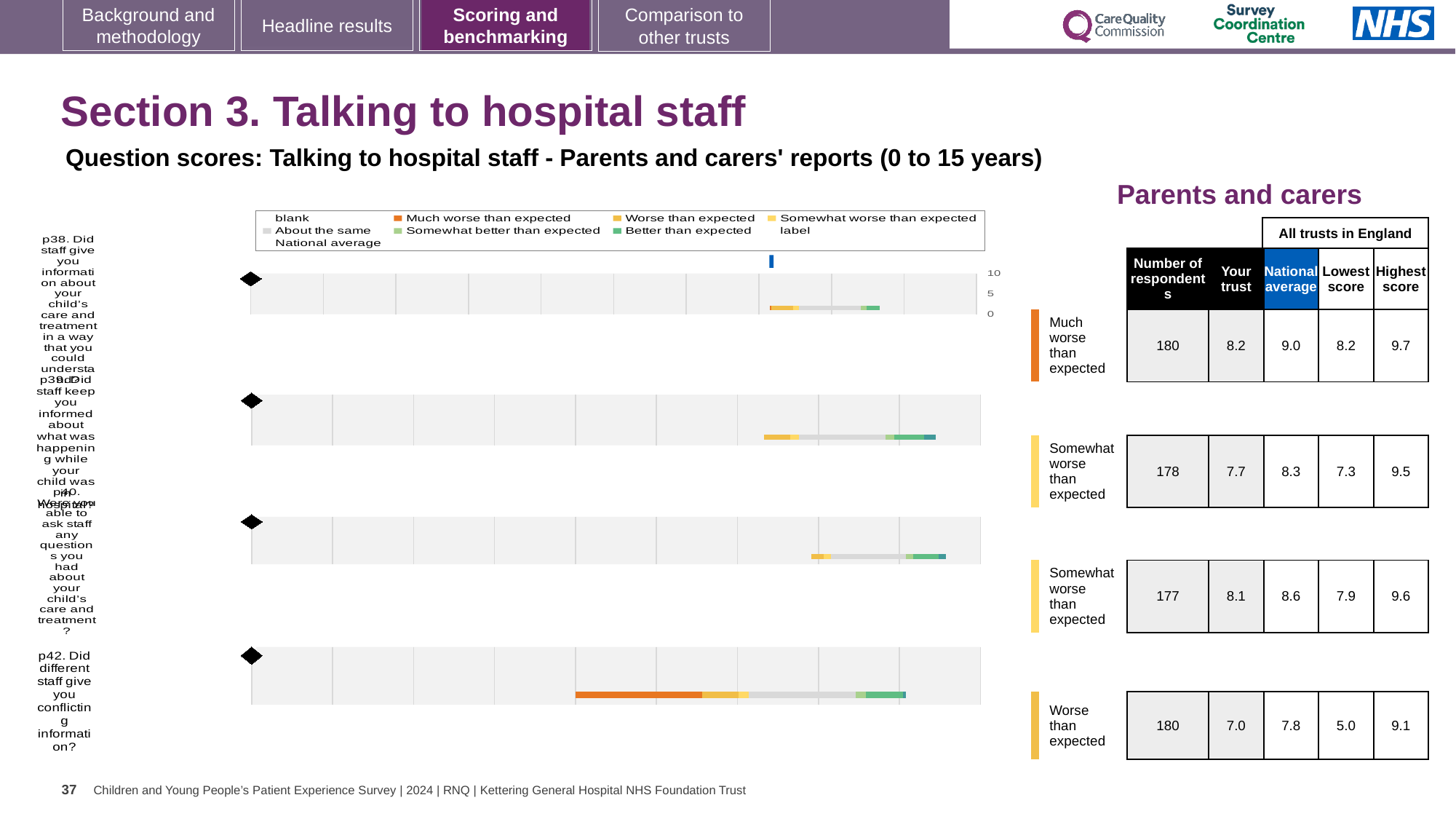
What kind of chart is used to show the question scores on this slide? bar chart What is the national average score for p42 (Did different staff give you conflicting information)? 7.8 What benchmark category is shown for p42 (Did different staff give you conflicting information)? Worse than expected What is the difference between the national average and the 'Your trust' score for p38? 0.8 What is the highest score among all trusts in England for p39 (Did staff keep you informed about what was happening while your child was in hospital)? 9.5 How many survey questions (p38, p39, p40, p42) are plotted as bars on the slide? 4 Which has the larger 'Your trust' score, p39 or p40? p40 What is the difference between the highest score and the lowest score for p42? 4.1 What is the 'Your trust' score for p38 (Did staff give you information about your child's care and treatment in a way that you could understand)? 8.2 Which question has the lowest 'Your trust' score on the slide? p42 How many respondents answered p40 (Were you able to ask staff any questions you had about your child's care and treatment)? 177 Which question has the highest 'Your trust' score on the slide? p38